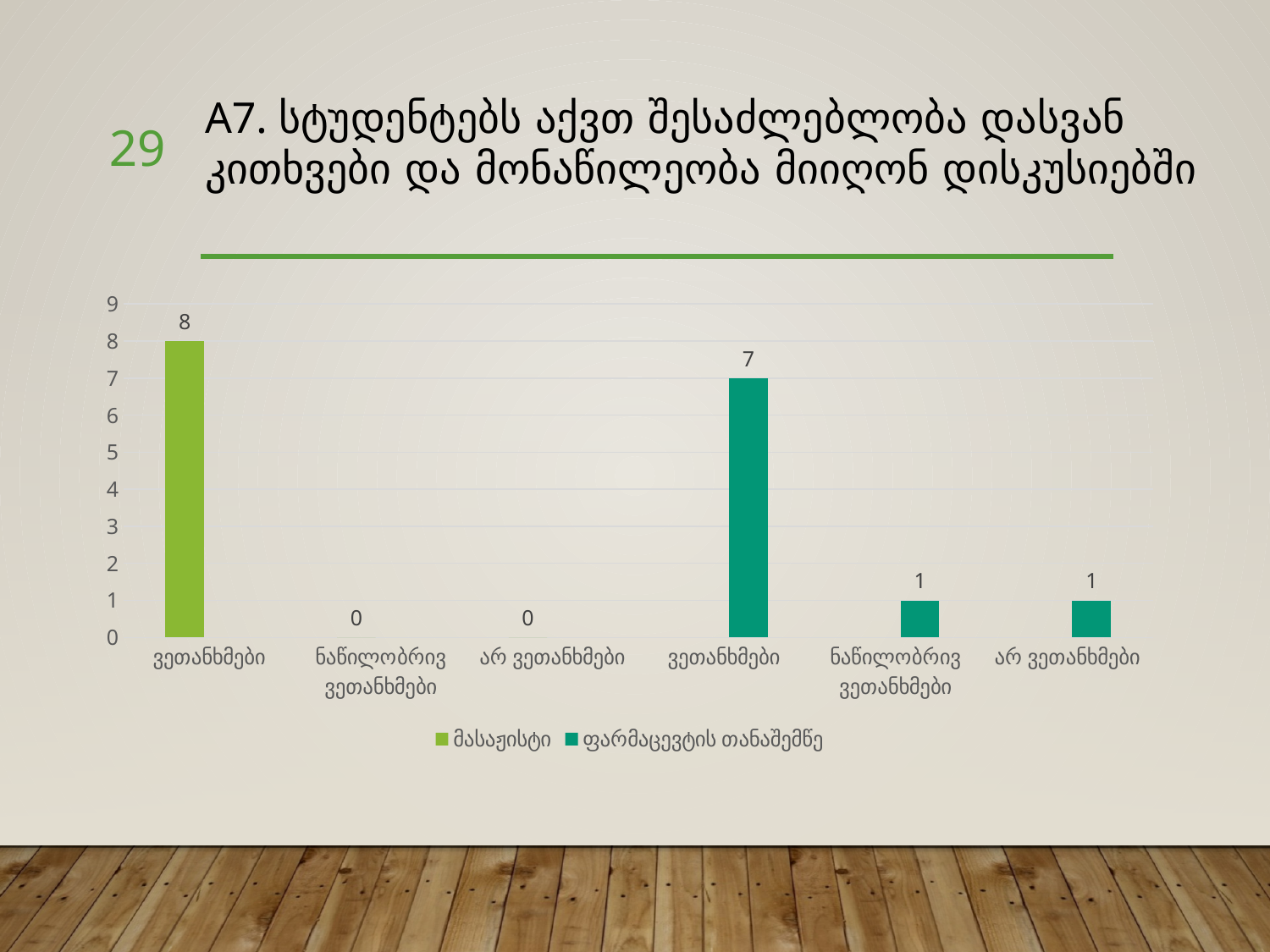
What is the value of the first bar (ვეთანხმები) for the მასაჟისტი series? 8 What is the value of the არ ვეთანხმები bar for the მასაჟისტი series? 0 What is the value of the ვეთანხმები bar for the ფარმაცევტის თანაშემწე series? 7 Which is larger: the ვეთანხმები value for მასაჟისტი or the ვეთანხმები value for ფარმაცევტის თანაშემწე? მასაჟისტი What are the two legend entries of the chart? მასაჟისტი and ფარმაცევტის თანაშემწე How many bars (category positions) are shown along the x axis? 6 What is the value of the ნაწილობრივ ვეთანხმები bar for the ფარმაცევტის თანაშემწე series? 1 What is the difference between the ვეთანხმები value for მასაჟისტი and the ვეთანხმები value for ფარმაცევტის თანაშემწე? 1 What is the highest value shown on the vertical axis? 9 How many series does the legend list? 2 What type of chart is shown on the slide? bar chart Which bar has the highest value on the chart? ვეთანხმები (მასაჟისტი), 8